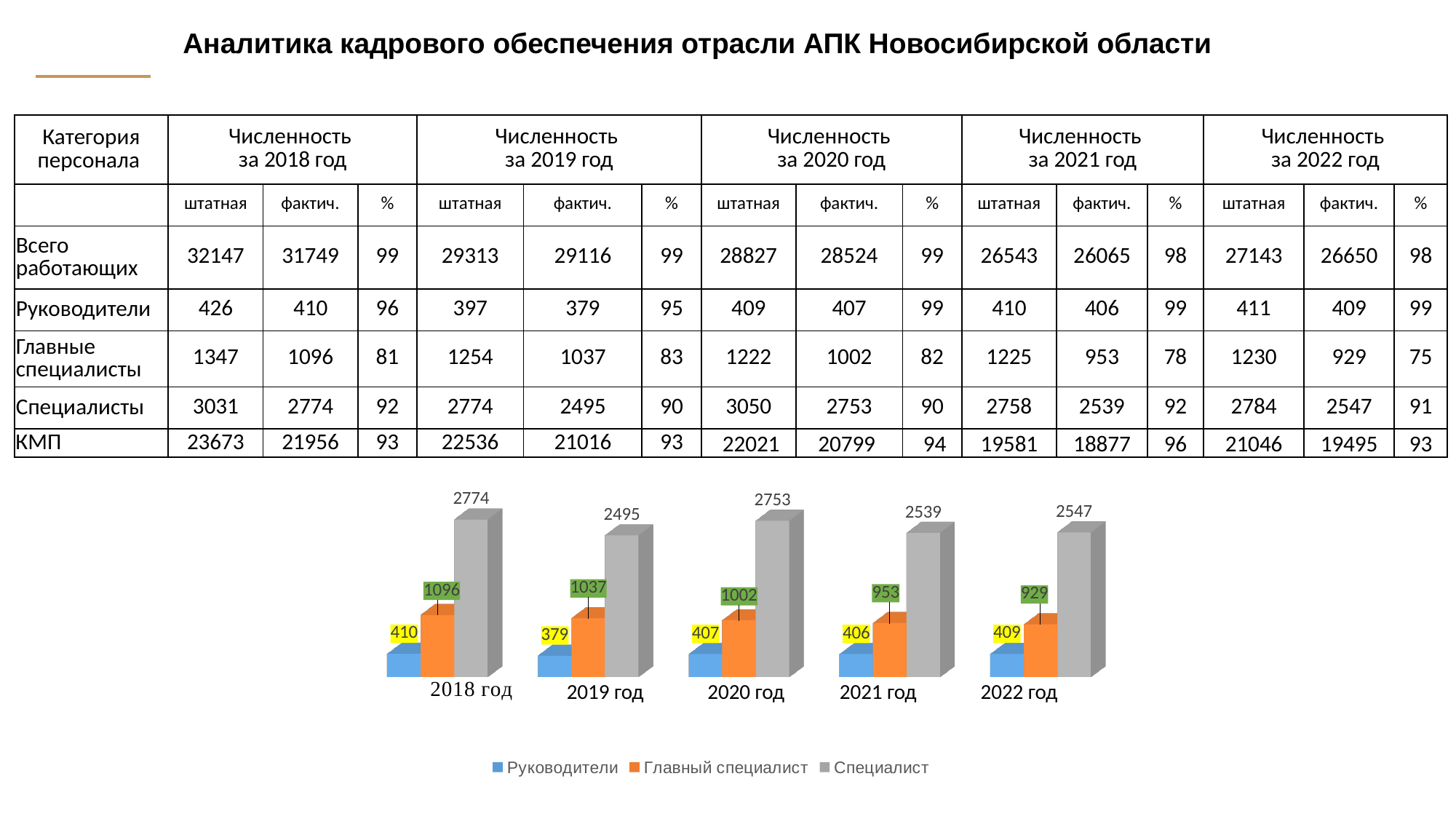
What kind of chart is shown on the slide? bar chart What is the difference between the Специалист values for 2018 год and 2019 год? 279 How many series does the chart legend list? 3 In which year is the Специалист value highest? 2018 год What is the value for Специалист in 2018 год? 2774 What is the value for Руководители in 2019 год? 379 How many years are shown on the x axis of the chart? 5 In which year is the Руководители value lowest? 2019 год What colour represents Специалист in the chart legend? grey What is the value for Главный специалист in 2021 год? 953 Which is larger: Главный специалист in 2018 год or in 2020 год? 2018 год Do the Главный специалист values rise or fall from 2018 год to 2022 год? fall